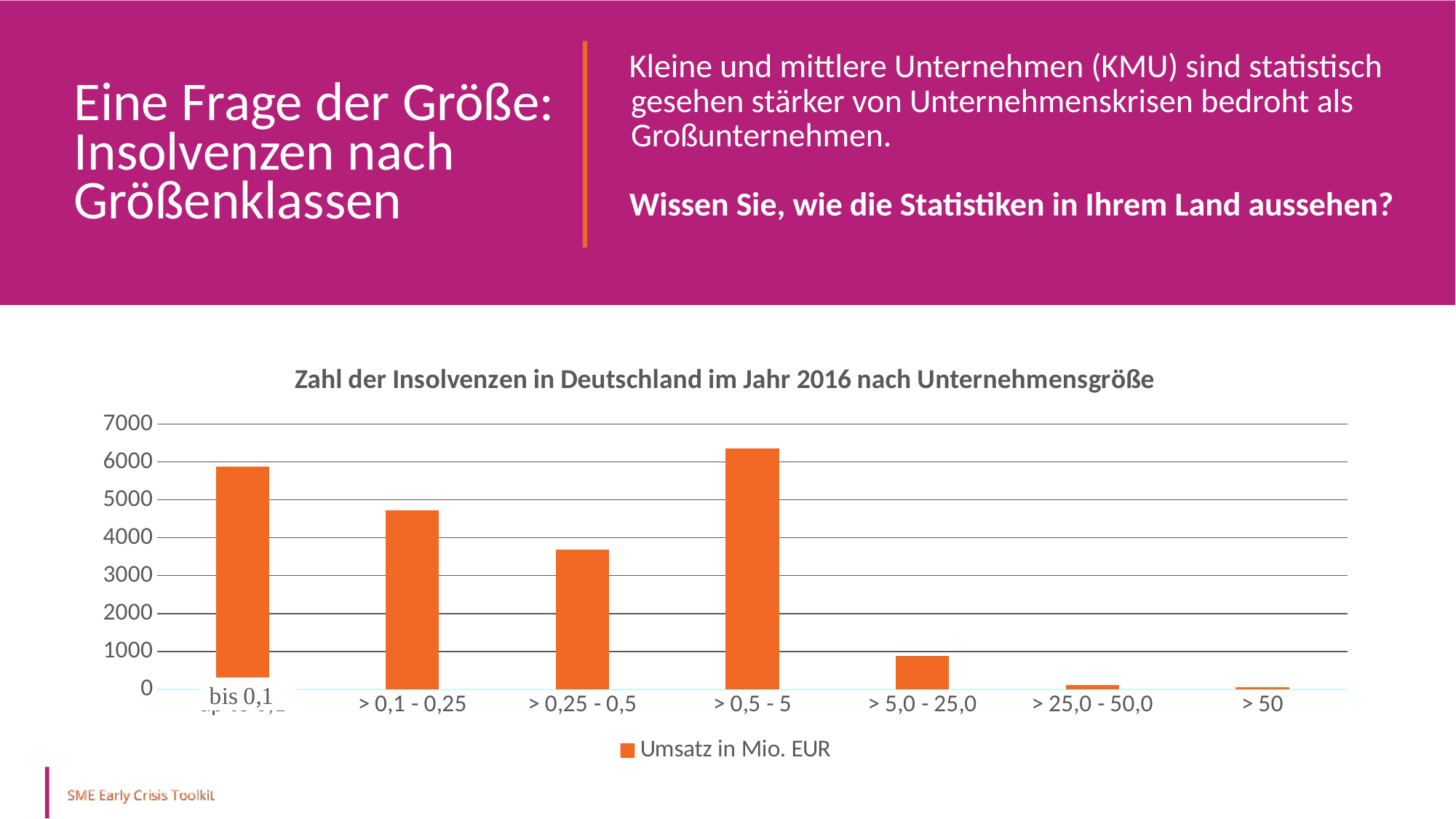
How many categories (size classes) are shown on the x axis of the chart? 7 Is the value for the category '> 5,0 - 25,0' greater or less than 1000? less Which category has the highest number of insolvencies in the chart? > 0,5 - 5 What is the legend entry of the series shown in the chart? Umsatz in Mio. EUR Is the value for the category 'bis 0,1' greater or less than 5000? greater Is the value for the category '> 0,1 - 0,25' greater or less than 5000? less Which has the larger value: 'bis 0,1' or '> 0,1 - 0,25'? bis 0,1 What kind of chart is shown on the slide? bar chart Which has the larger value: '> 0,25 - 0,5' or '> 5,0 - 25,0'? > 0,25 - 0,5 How many series does the chart legend list? 1